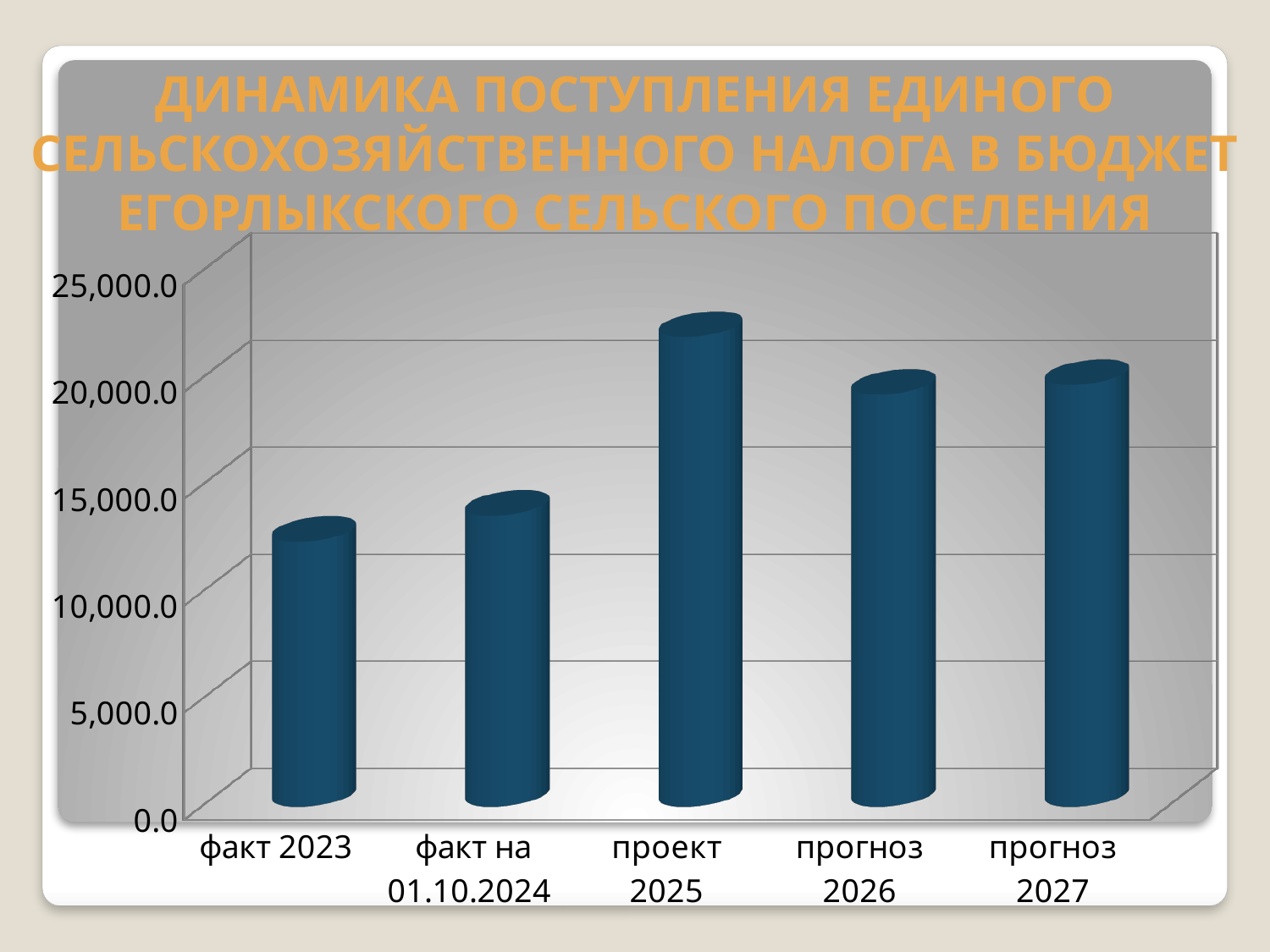
Which is larger, the value for факт на 01.10.2024 or the value for прогноз 2026? прогноз 2026 What is the title of the chart on the slide? ДИНАМИКА ПОСТУПЛЕНИЯ ЕДИНОГО СЕЛЬСКОХОЗЯЙСТВЕННОГО НАЛОГА В БЮДЖЕТ ЕГОРЛЫКСКОГО СЕЛЬСКОГО ПОСЕЛЕНИЯ Is the value for проект 2025 greater or less than 25,000.0? less Which is larger, the value for факт 2023 or the value for проект 2025? проект 2025 Which category has the highest value in the chart? проект 2025 Is the value for факт 2023 greater or less than 15,000.0? less What kind of chart is shown on the slide? bar chart Is the value for факт на 01.10.2024 greater or less than 10,000.0? greater Which category has the lowest value in the chart? факт 2023 How many categories are shown on the x axis of the chart? 5